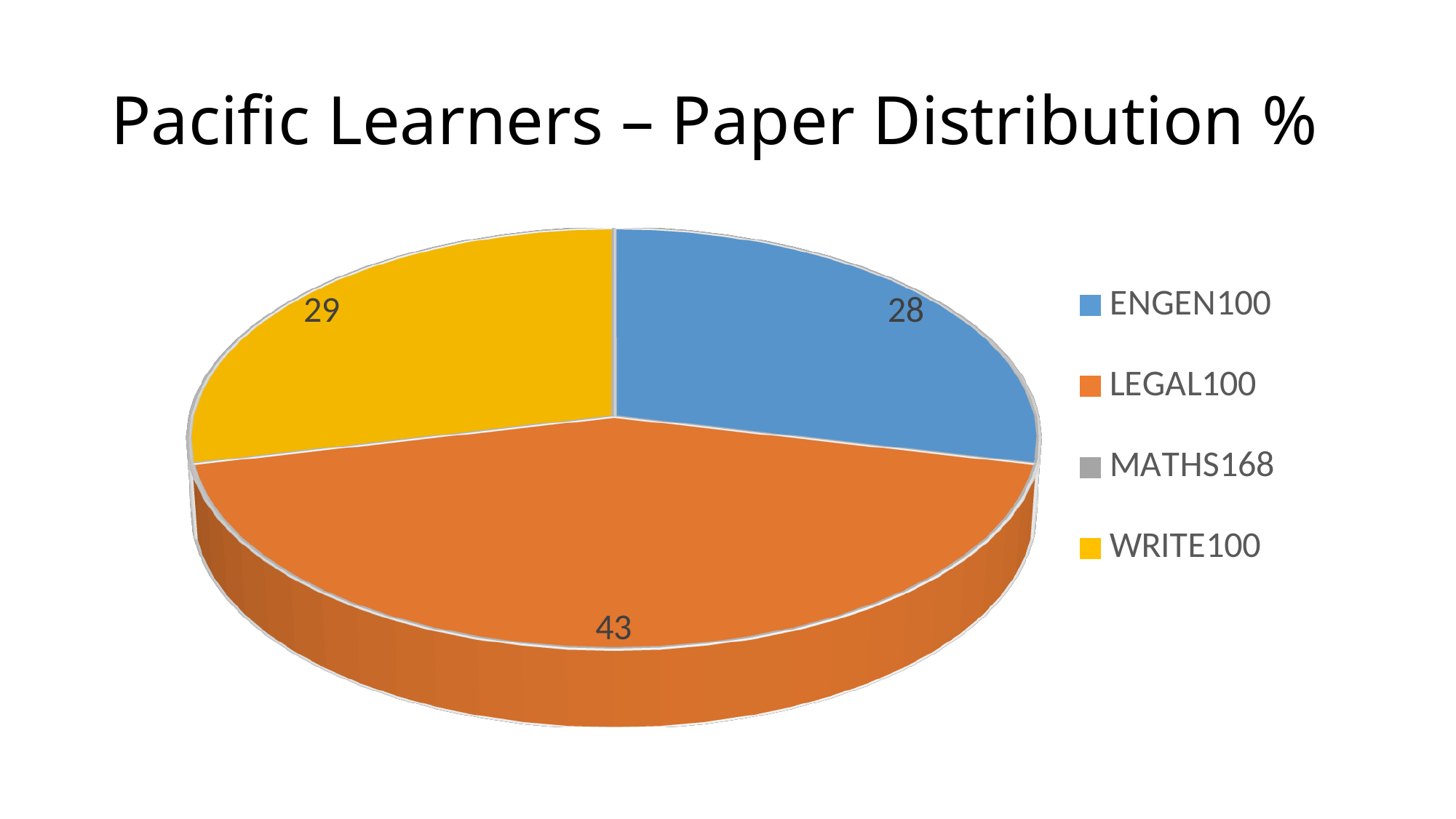
What is the difference between the LEGAL100 value and the ENGEN100 value? 15 Which is larger, the value for WRITE100 or the value for ENGEN100? WRITE100 How many slices are visible in the pie chart? 3 Which labelled slice has the smallest value? ENGEN100 What value is shown for the ENGEN100 slice? 28 What value is shown for the LEGAL100 slice? 43 What is the title of the chart? Pacific Learners – Paper Distribution % What value is shown for the WRITE100 slice? 29 What is the difference between the WRITE100 value and the ENGEN100 value? 1 Which paper has the largest slice of the pie? LEGAL100 How many entries does the legend list? 4 What kind of chart is shown on the slide? Pie chart